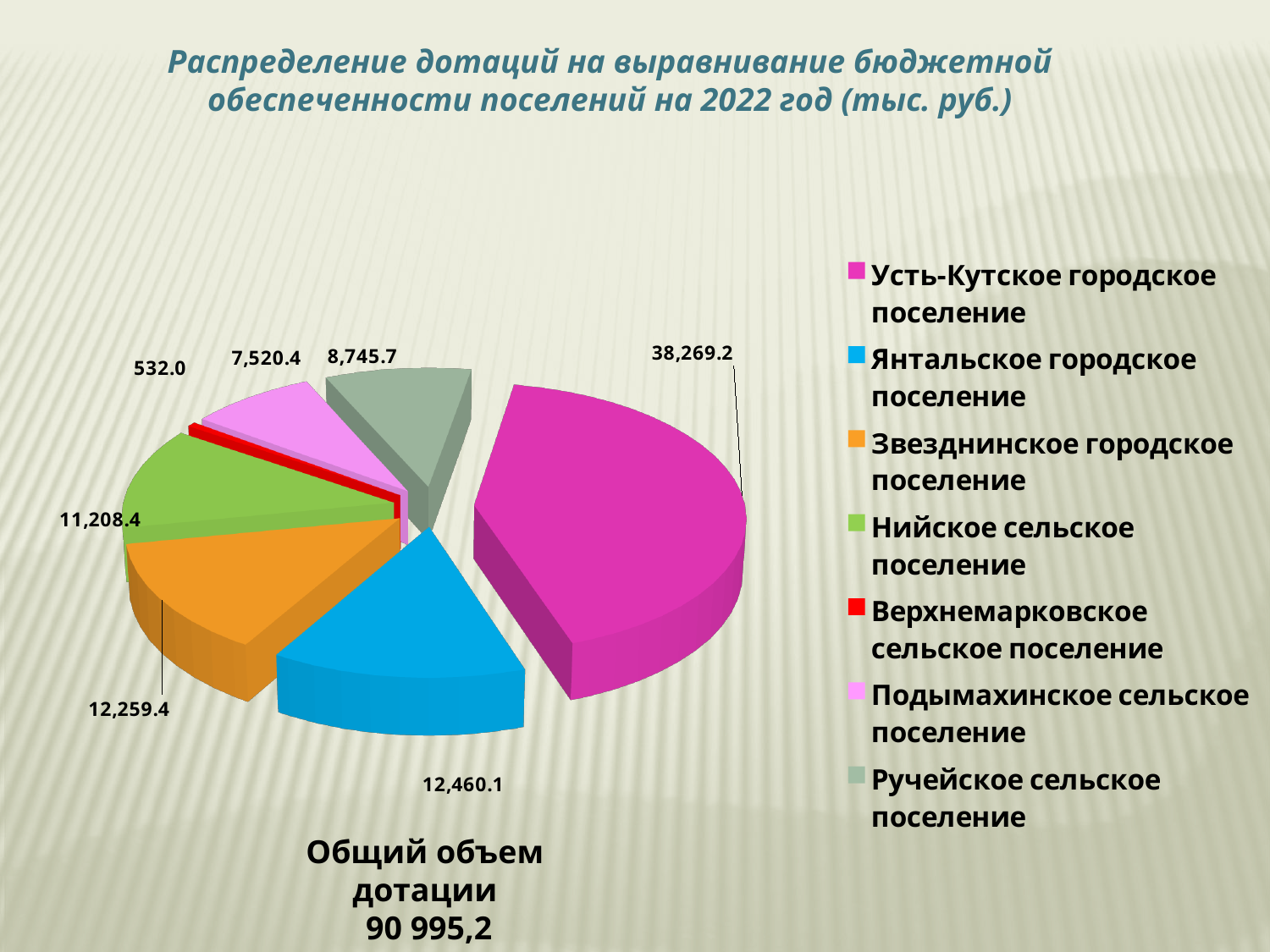
What type of chart is shown on the slide? Pie chart What is the value for Усть-Кутское городское поселение? 38,269.2 What is the value for Ручейское сельское поселение? 8,745.7 What is the difference between the values for Усть-Кутское городское поселение and Янтальское городское поселение? 25,809.1 Which is larger: the value for Янтальское городское поселение or for Звезднинское городское поселение? Янтальское городское поселение What is the value for Верхнемарковское сельское поселение? 532.0 How many categories (settlements) does the pie chart show? 7 What colour is the slice for Нийское сельское поселение? Green What is the value for Янтальское городское поселение? 12,460.1 Which settlement receives the largest share of the subsidy? Усть-Кутское городское поселение What is the total volume of the subsidy stated on the slide? 90 995,2 Which settlement receives the smallest share of the subsidy? Верхнемарковское сельское поселение